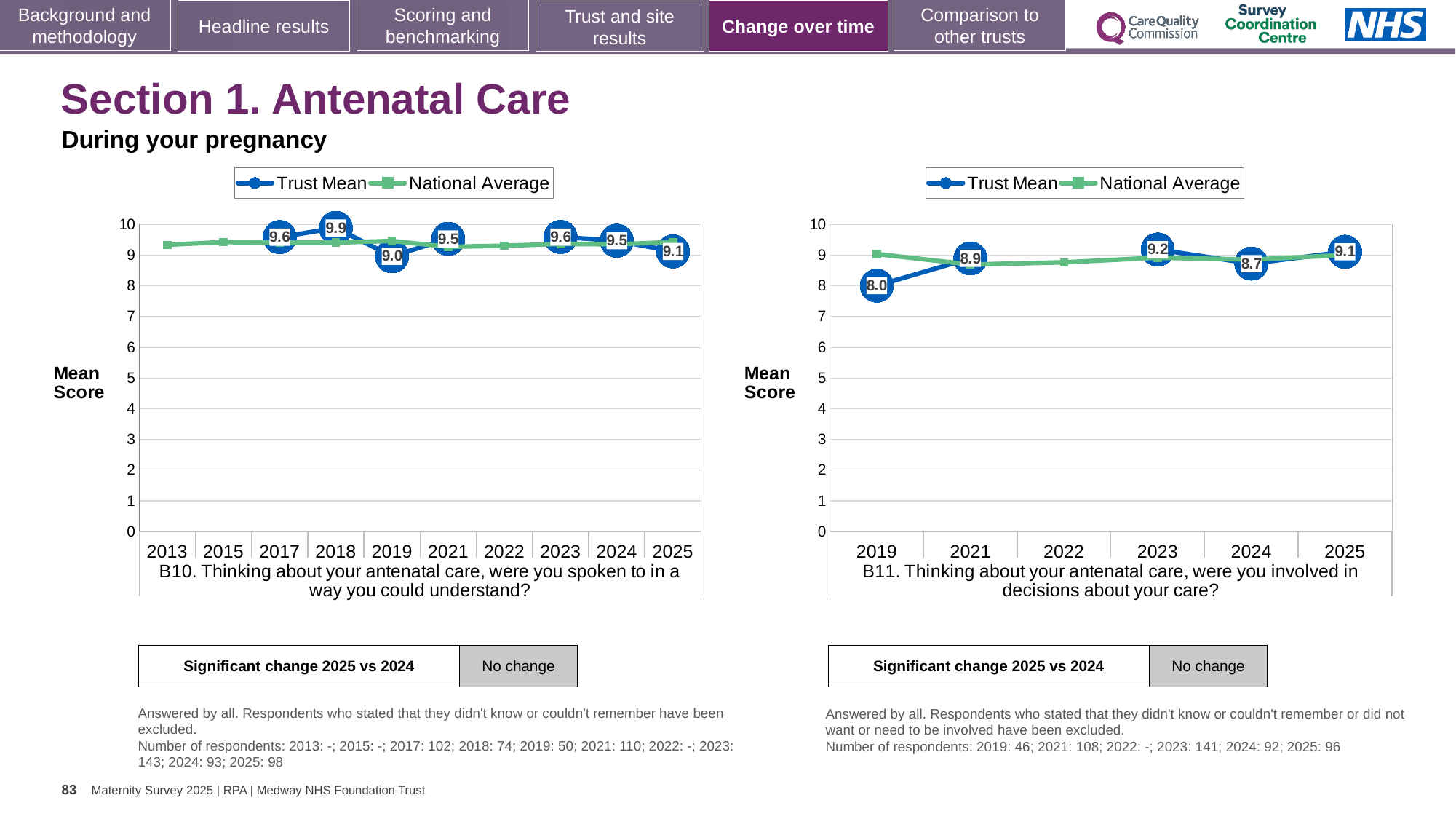
In the B11 chart, is the Trust Mean for 2024 larger or smaller than the Trust Mean for 2025? smaller In the B11 chart, what is the Trust Mean for 2023? 9.2 In the B10 chart, what is the Trust Mean for 2019? 9.0 In the B10 chart, what is the Trust Mean for 2018? 9.9 In the B10 chart, which year has the highest labelled Trust Mean? 2018 In the B10 chart, how many years are shown on the x axis? 10 What type of chart is the B11 chart? line chart In the B11 chart, what is the Trust Mean for 2019? 8.0 In the B10 chart, what is the difference between the Trust Mean for 2018 and the Trust Mean for 2025? 0.8 In the B10 chart, which year has the lowest labelled Trust Mean? 2019 In the B11 chart, which year has the lowest Trust Mean? 2019 In the B11 chart, how many series does the legend list? 2